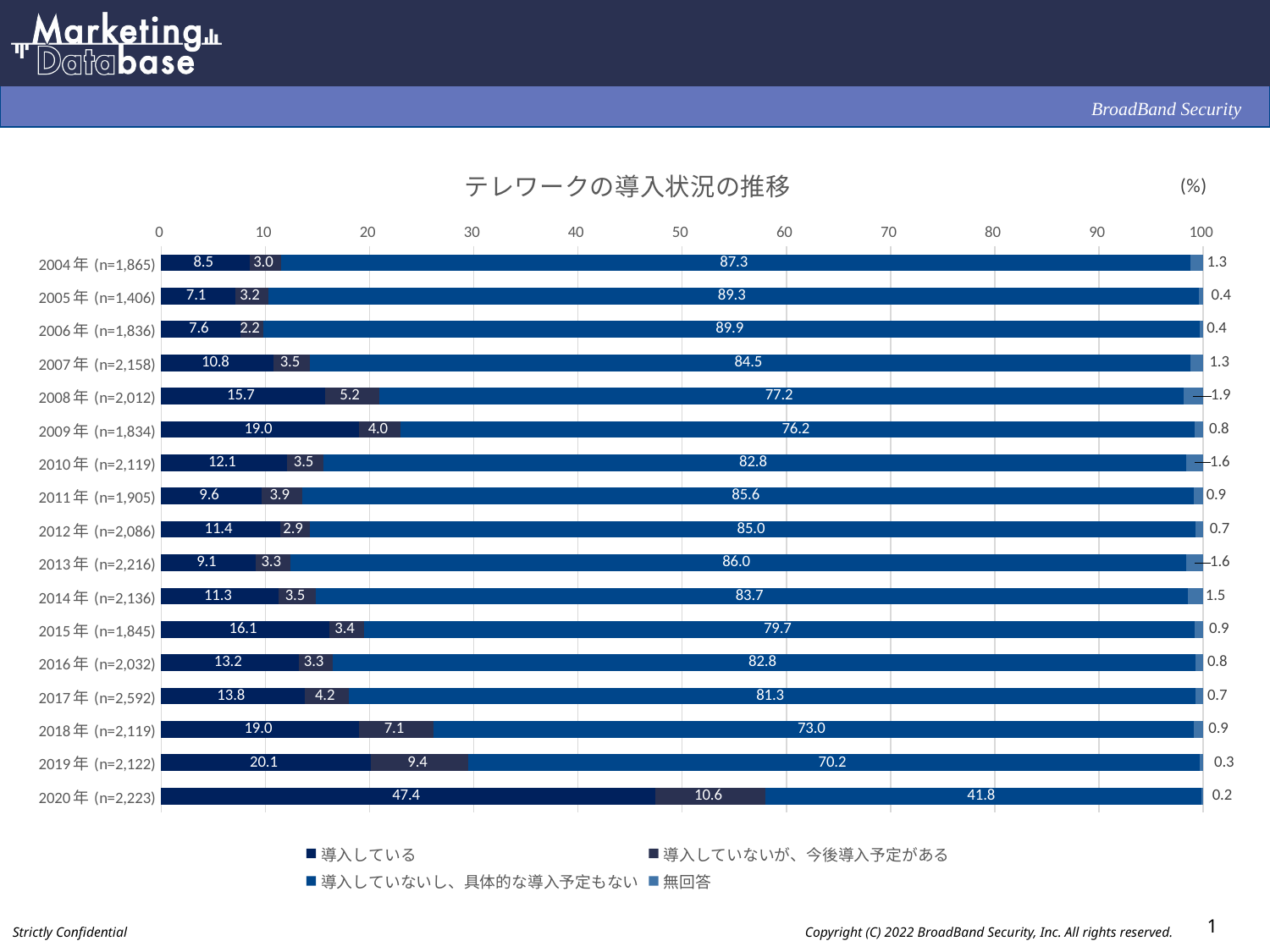
How many series does the legend list? 4 What is the title of the chart? テレワークの導入状況の推移 Which year has the lowest value for 導入している? 2005年 (n=1,406) Which year has the highest value for 導入している? 2020年 (n=2,223) How many years (categories) are shown on the chart? 17 What is the value for 導入していないし、具体的な導入予定もない in 2019年 (n=2,122)? 70.2 What is the value for 無回答 in 2008年 (n=2,012)? 1.9 What is the difference between the 導入している values for 2020年 and 2019年? 27.3 What is the value for 導入している in 2020年 (n=2,223)? 47.4 What kind of chart is shown on the slide? Stacked bar chart What is the total of the stacked bar for 2020年 (n=2,223)? 100.0 Which is larger, the 導入している value for 2018年 or for 2017年? 2018年